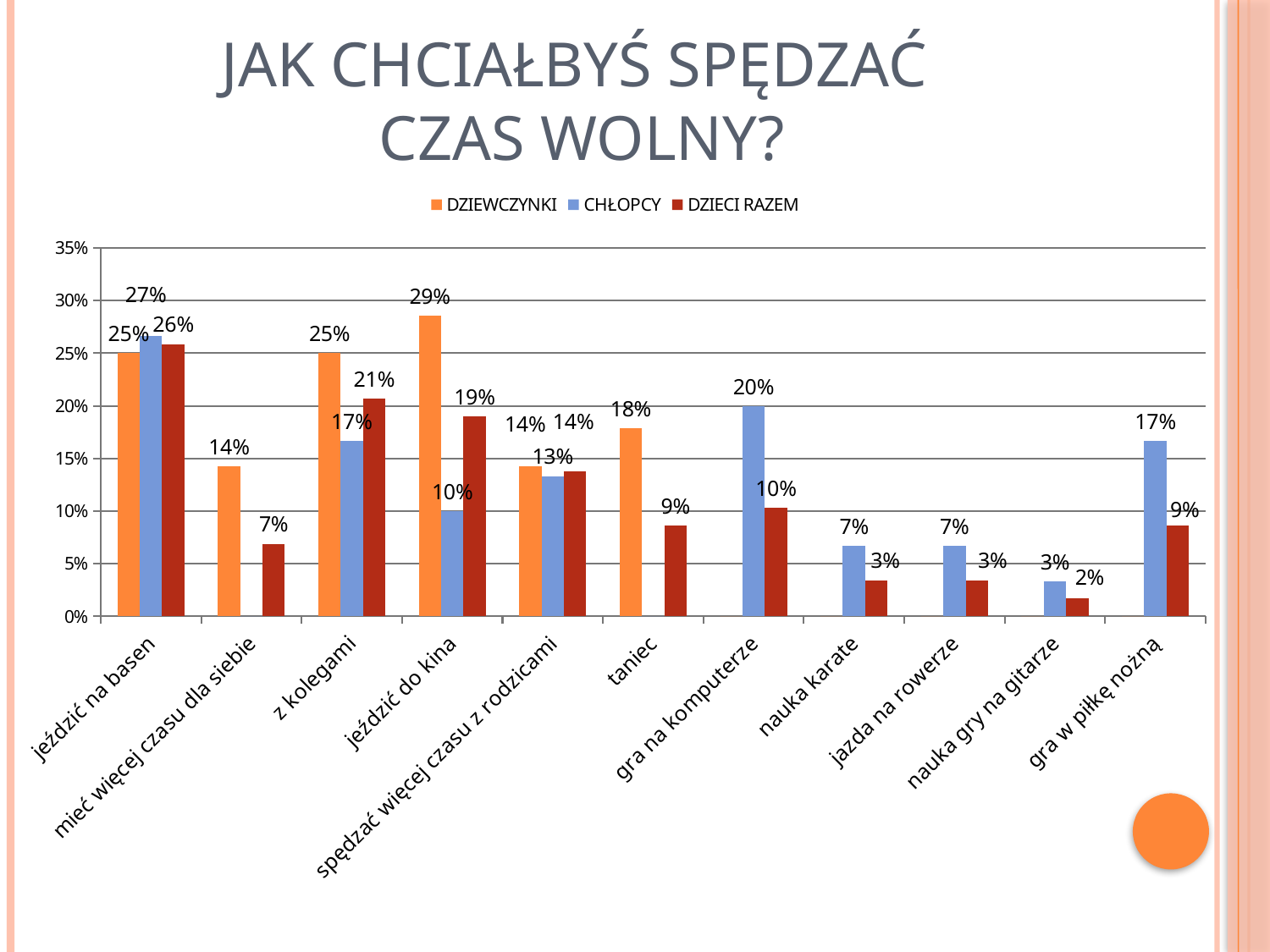
What is the CHŁOPCY value for "gra na komputerze"? 20% What is the DZIECI RAZEM value for "z kolegami"? 21% How many series does the legend list? 3 Which is larger for "jeździć na basen": the DZIEWCZYNKI value or the CHŁOPCY value? CHŁOPCY What kind of chart is shown on the slide? bar chart How many categories are shown on the x axis? 11 What is the DZIEWCZYNKI value for "jeździć do kina"? 29% What is the CHŁOPCY value for "gra w piłkę nożną"? 17% Which category has the lowest DZIECI RAZEM value? nauka gry na gitarze What is the difference between the DZIEWCZYNKI and CHŁOPCY values for "jeździć do kina"? 19% Which category has the highest DZIEWCZYNKI value? jeździć do kina Which series is shown in orange in the legend? DZIEWCZYNKI